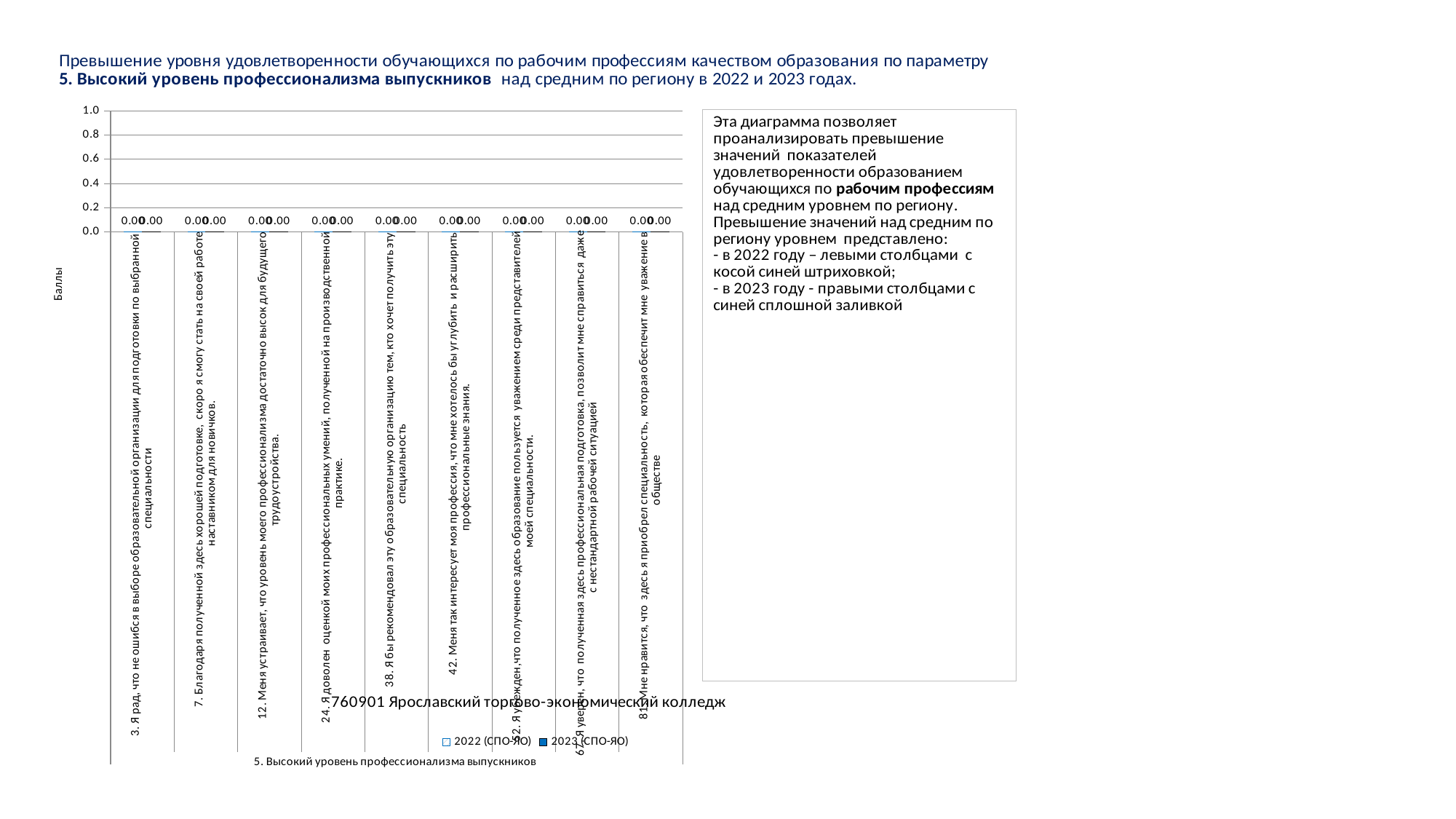
What is the difference between the 2022 (СПО-ЯО) and 2023 (СПО-ЯО) values for statement 12? 0.00 How many categories (statements) are plotted along the x axis of the chart? 9 Is the value for 2023 (СПО-ЯО) for statement 24 greater or less than 0.2? less What is the value for 2023 (СПО-ЯО) for statement 81 ("Мне нравится, что здесь я приобрел специальность...")? 0.00 What kind of chart is shown on the slide? bar chart How many series does the chart legend list? 2 What is the value for 2022 (СПО-ЯО) for statement 3 ("Я рад, что не ошибся в выборе образовательной организации...")? 0.00 What are the two series names listed in the chart legend? 2022 (СПО-ЯО) and 2023 (СПО-ЯО) What is the label of the vertical axis of the chart? Баллы Do the plotted values change along the x axis, or stay the same? stay the same What is the value for 2022 (СПО-ЯО) for statement 42 ("Меня так интересует моя профессия...")? 0.00 What is the highest value shown on the vertical axis of the chart? 1.0